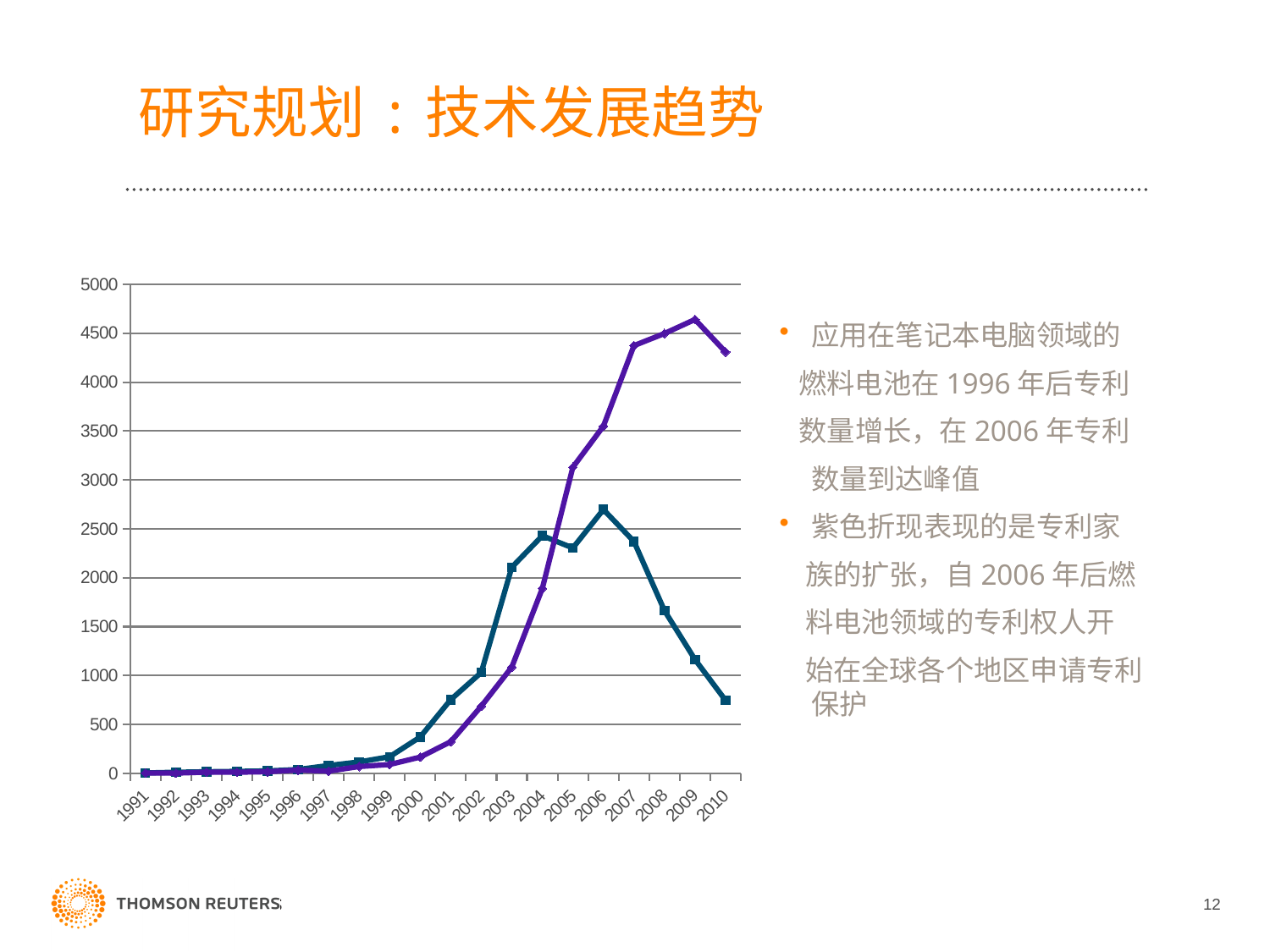
What kind of chart is shown on the slide? line chart How many years are shown along the x axis of the chart? 20 Is the value of the teal line in 2010 greater or less than 1000? less In which year does the teal (dark blue) line reach its highest value? 2006 How many lines (data series) are plotted on the chart? 2 Does the teal line rise or fall from 2006 to 2010? fall In which year does the purple line reach its highest value? 2009 In 2003, which line has the higher value, the teal line or the purple line? the teal line In 2008, which line has the higher value, the teal line or the purple line? the purple line Is the value of the purple line in 2005 greater or less than 3000? greater Is the value of the teal line in 2006 greater or less than 2500? greater